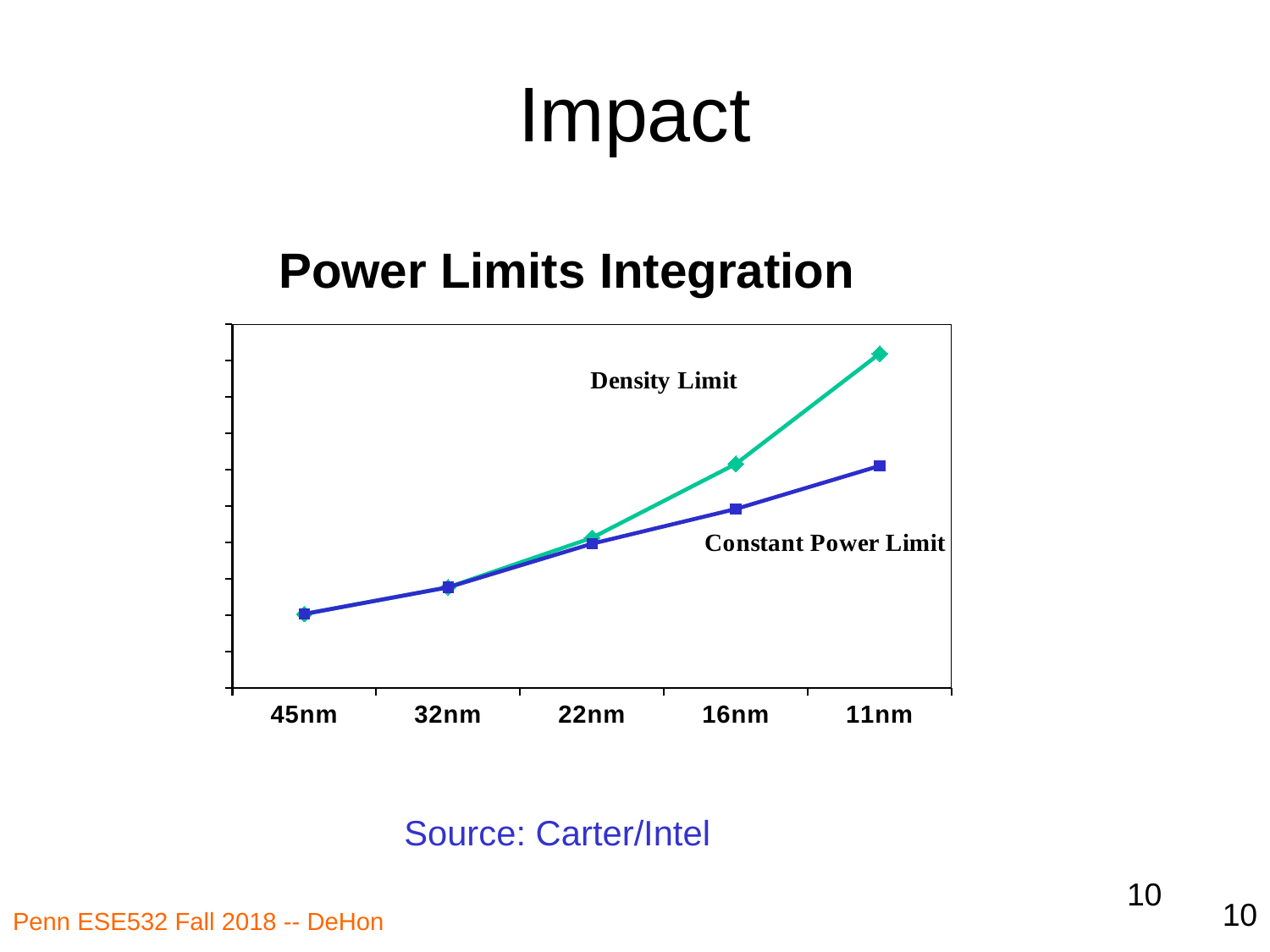
Do the values of the Density Limit series rise or fall moving from 45nm to 11nm along the x axis? rise At which process node does the Constant Power Limit series have its lowest value? 45nm How many process nodes are shown along the x axis of the chart? 5 What are the names of the two series plotted in the chart? Density Limit and Constant Power Limit Do the values of the Constant Power Limit series rise or fall moving from 45nm to 11nm along the x axis? rise What kind of chart is shown on the slide? line chart At which process node does the Density Limit series reach its highest value? 11nm How many series are plotted in the chart? 2 What is the title of the chart? Power Limits Integration Which process node is the first label on the x axis of the chart? 45nm At 16nm, which series has the larger value, Density Limit or Constant Power Limit? Density Limit At 11nm, which series has the larger value, Density Limit or Constant Power Limit? Density Limit